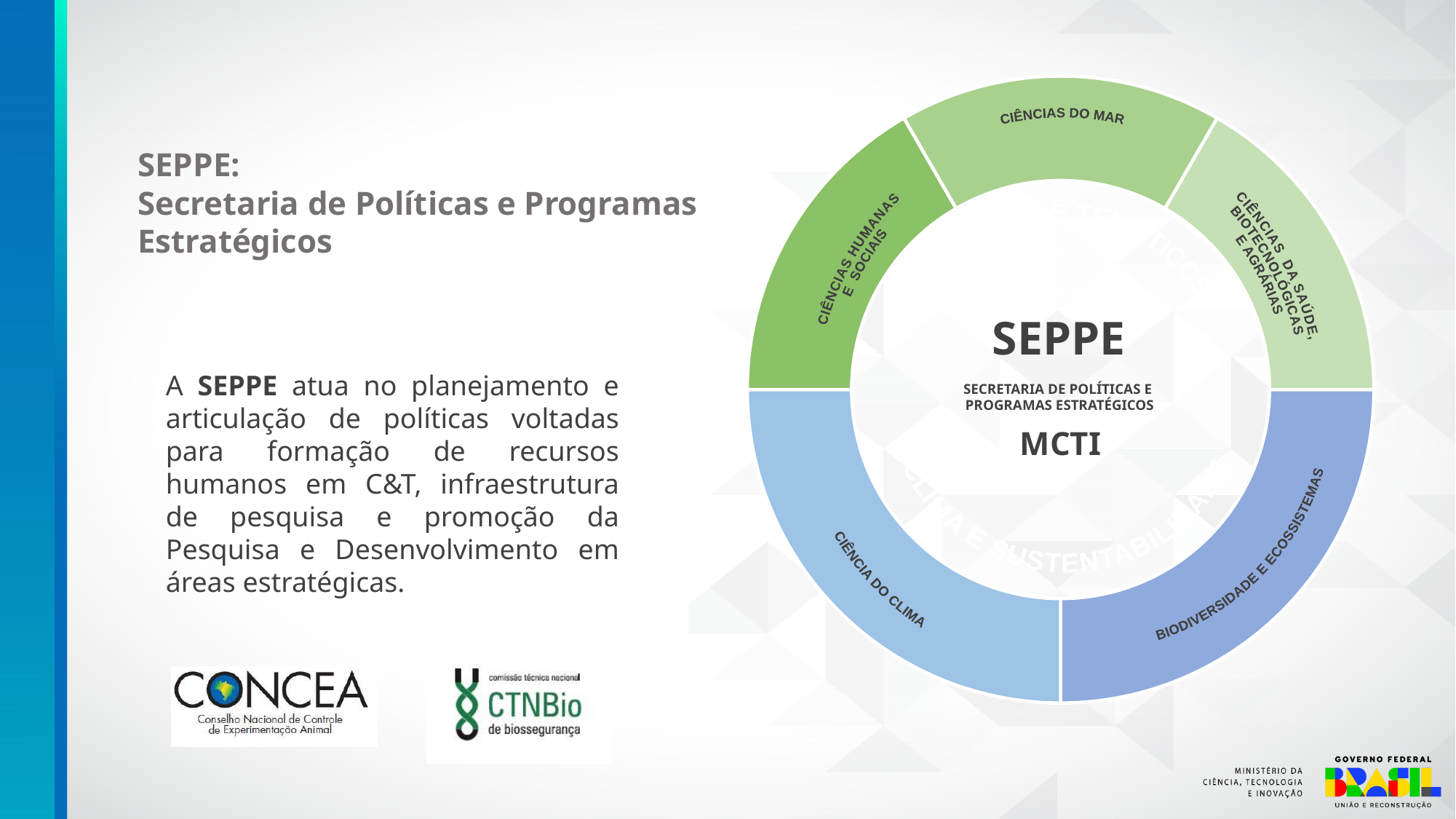
Which segment of the ring diagram is larger: CIÊNCIA DO CLIMA or CIÊNCIAS HUMANAS E SOCIAIS? CIÊNCIA DO CLIMA What text appears in the centre of the ring diagram, in the largest font? SEPPE What kind of chart is the diagram on the right of the slide? Doughnut (ring) chart Which segment of the ring diagram is larger: BIODIVERSIDADE E ECOSSISTEMAS or CIÊNCIAS DO MAR? BIODIVERSIDADE E ECOSSISTEMAS How many segments does the ring diagram around SEPPE contain? 5 Which segment of the ring diagram sits at the top? CIÊNCIAS DO MAR